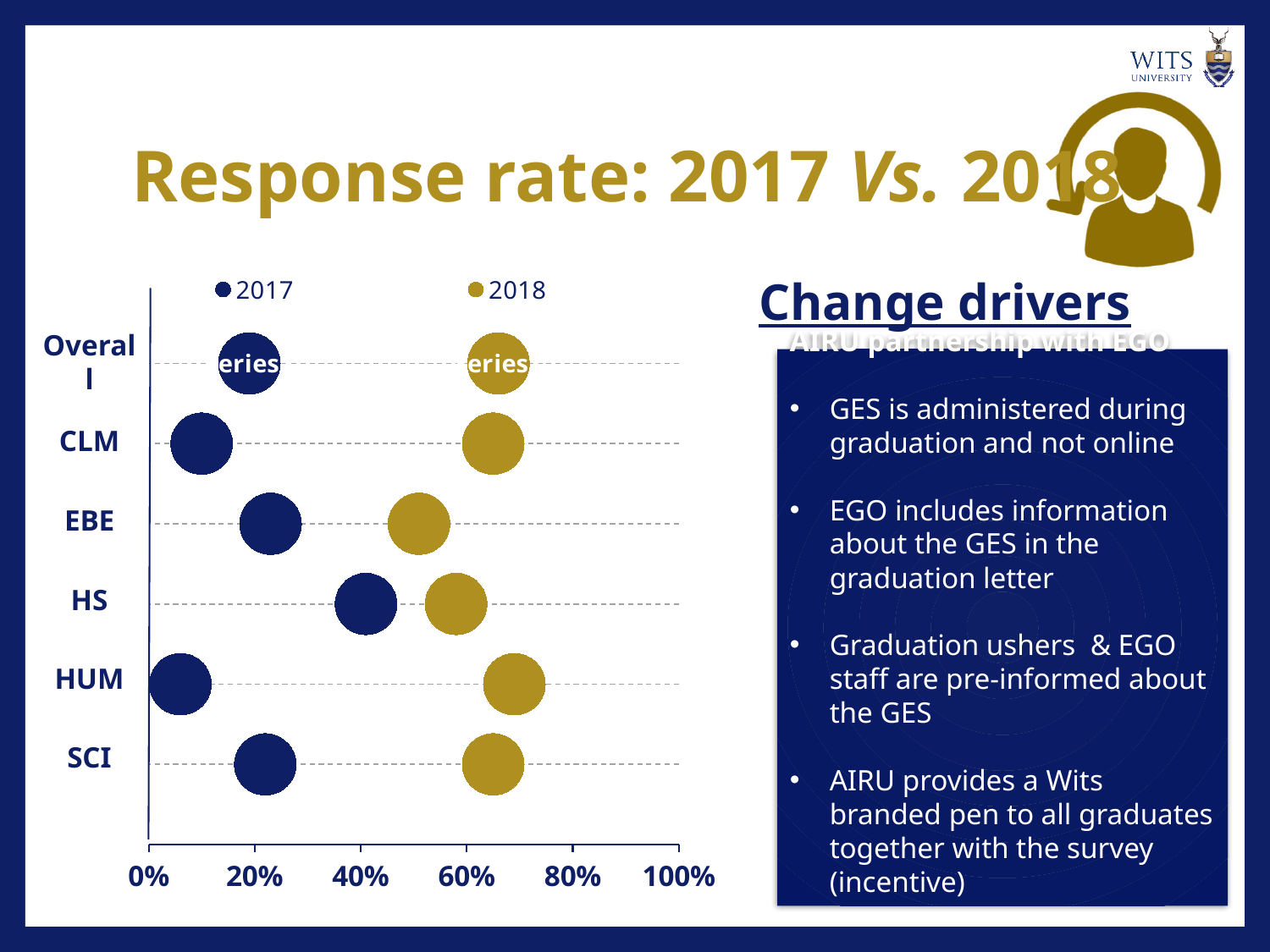
Is the 2017 response rate for HUM greater or less than 20%? less Which category has the highest 2017 response rate? HS How many series does the chart legend list? 2 What kind of chart is shown on the slide? bubble chart For HUM, which year has the higher response rate, 2017 or 2018? 2018 How many categories are plotted on the vertical axis of the chart? 6 Is the 2018 response rate for EBE greater or less than 60%? less Which series is shown in gold in the chart? 2018 Is the 2017 response rate for HS greater or less than 20%? greater Which category has the lowest 2018 response rate? EBE What is the title of the slide containing the chart? Response rate: 2017 Vs. 2018